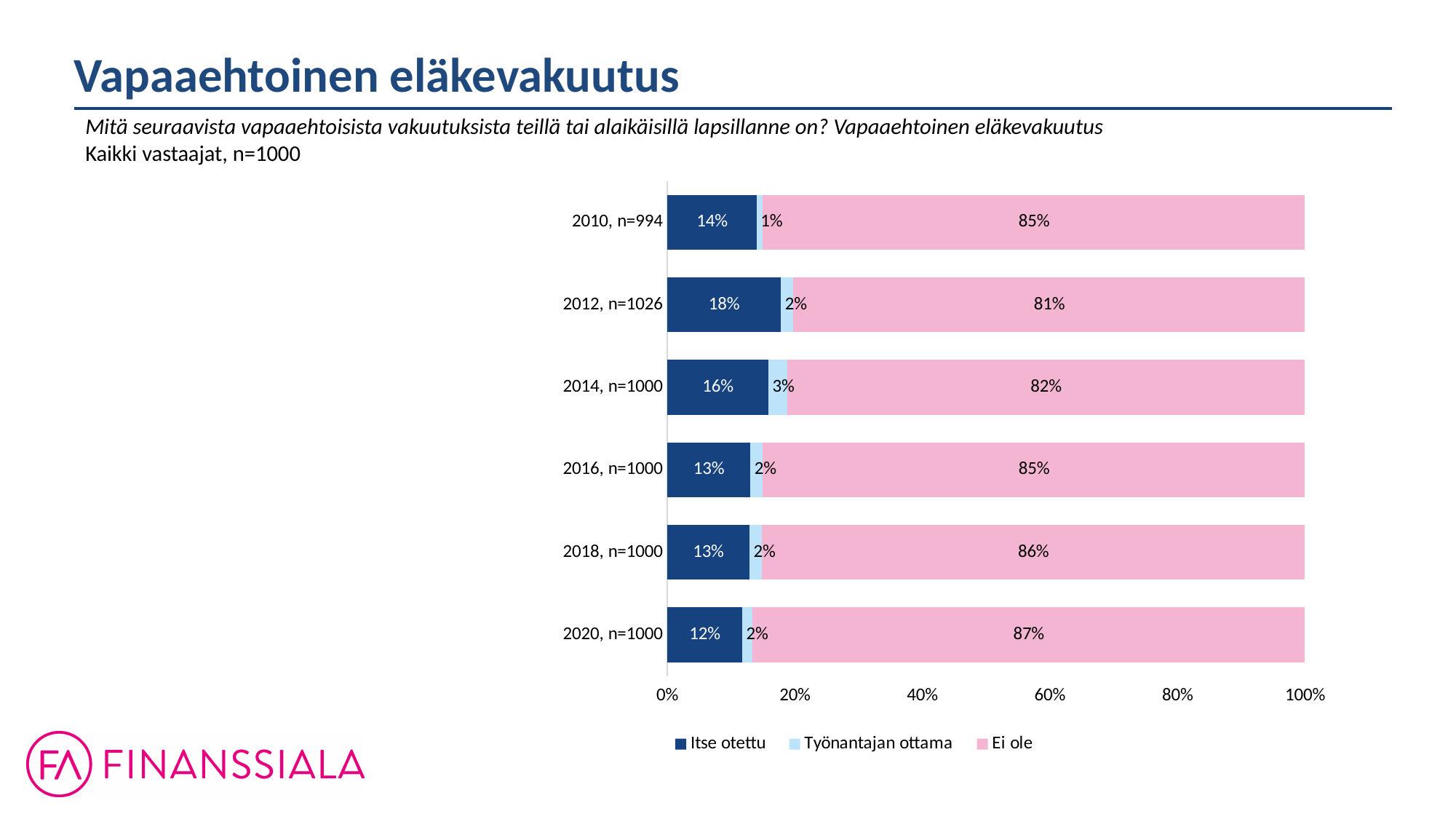
What is the difference between the "Itse otettu" values for 2012, n=1026 and 2020, n=1000? 6% What is the total of the stacked bar for 2014, n=1000? 101% Which year has the lowest value for "Ei ole"? 2012, n=1026 Which is larger: the "Ei ole" value for 2018, n=1000 or for 2014, n=1000? 2018, n=1000 What is the value for "Ei ole" in 2020, n=1000? 87% What is the value for "Työnantajan ottama" in 2014, n=1000? 3% How many series does the legend list? 3 How many year categories are shown on the chart? 6 Does the "Itse otettu" value rise or fall from 2012, n=1026 to 2020, n=1000? Fall What is the value for "Itse otettu" in 2010, n=994? 14% Which year has the highest value for "Itse otettu"? 2012, n=1026 What kind of chart is shown on the slide? Stacked bar chart